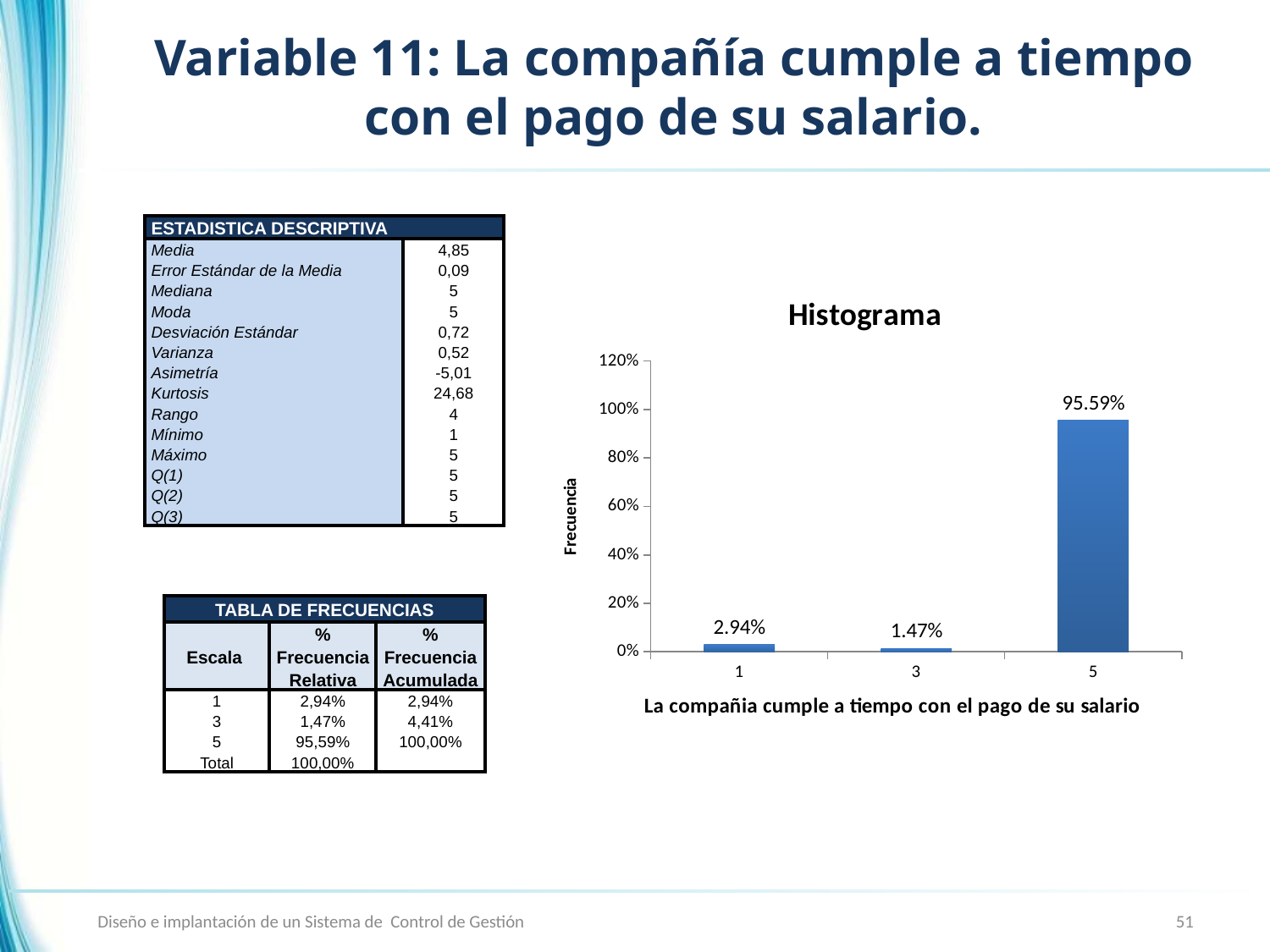
How many categories are shown on the x axis of the Histograma chart? 3 What is the value for category 5 in the Histograma chart? 95.59% What is the value for category 3 in the Histograma chart? 1.47% What is the difference between the values for category 1 and category 3 in the Histograma chart? 1.47% What kind of chart is the Histograma chart? bar chart What is the y-axis label of the Histograma chart? Frecuencia What is the title of the chart on the slide? Histograma What is the value for category 1 in the Histograma chart? 2.94% Which category has the lowest value in the Histograma chart? 3 Which category has the highest value in the Histograma chart? 5 Is the value for category 5 in the Histograma chart greater or less than 80%? greater Which is larger in the Histograma chart, the value for category 1 or category 3? 1